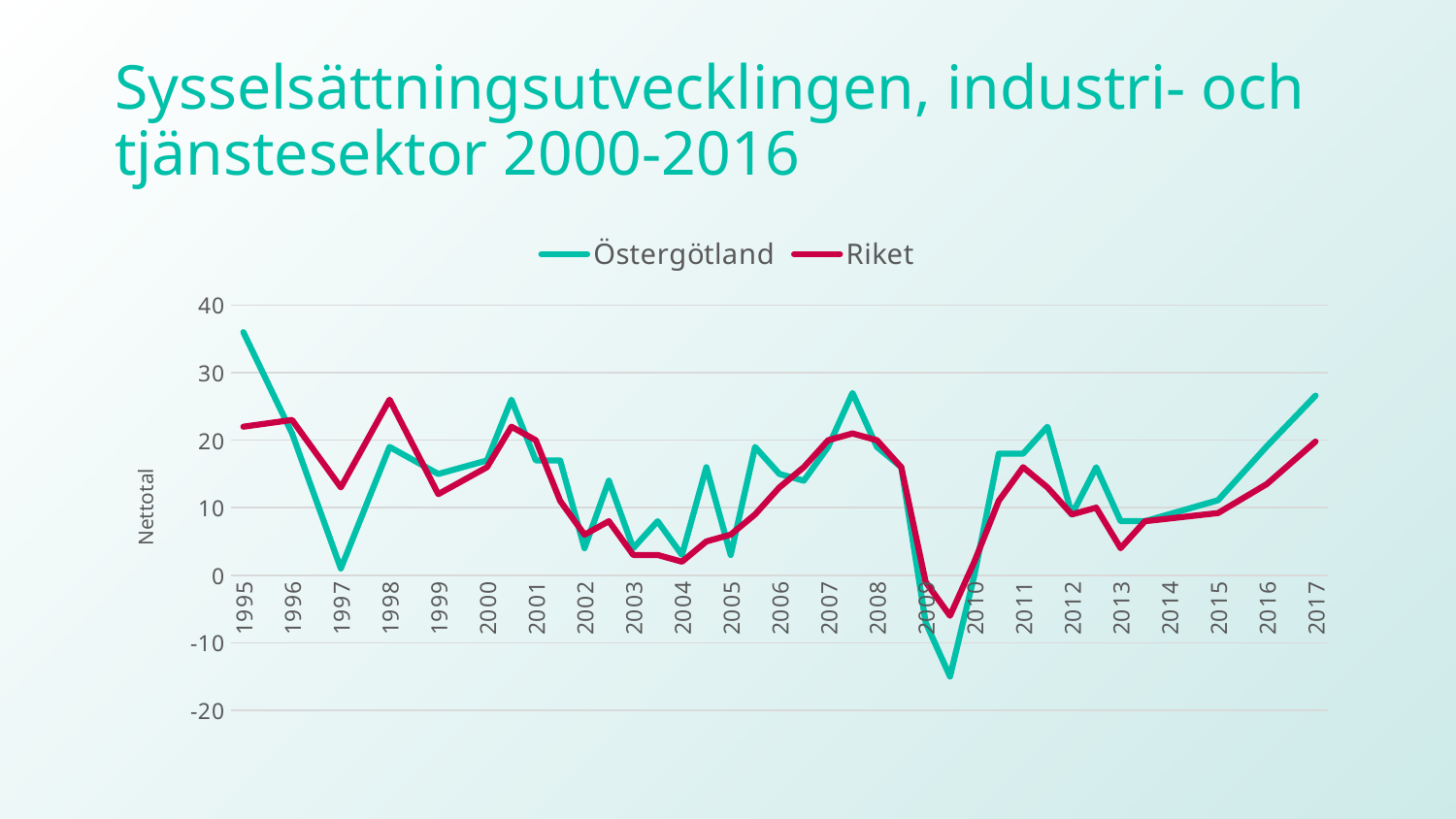
What is the label on the vertical axis? Nettotal Is the value for Östergötland in 1995 greater or less than 30? greater In which year does the Östergötland line reach its highest value? 1995 Which series has the higher value in 1997, Östergötland or Riket? Riket Is the value for Riket in 2013 greater or less than 10? less What are the two series named in the legend? Östergötland and Riket What kind of chart is shown on the slide? line chart Is the value for Riket in 1997 greater or less than 10? greater How many series does the legend list? 2 Which series has the higher value in 1995, Östergötland or Riket? Östergötland